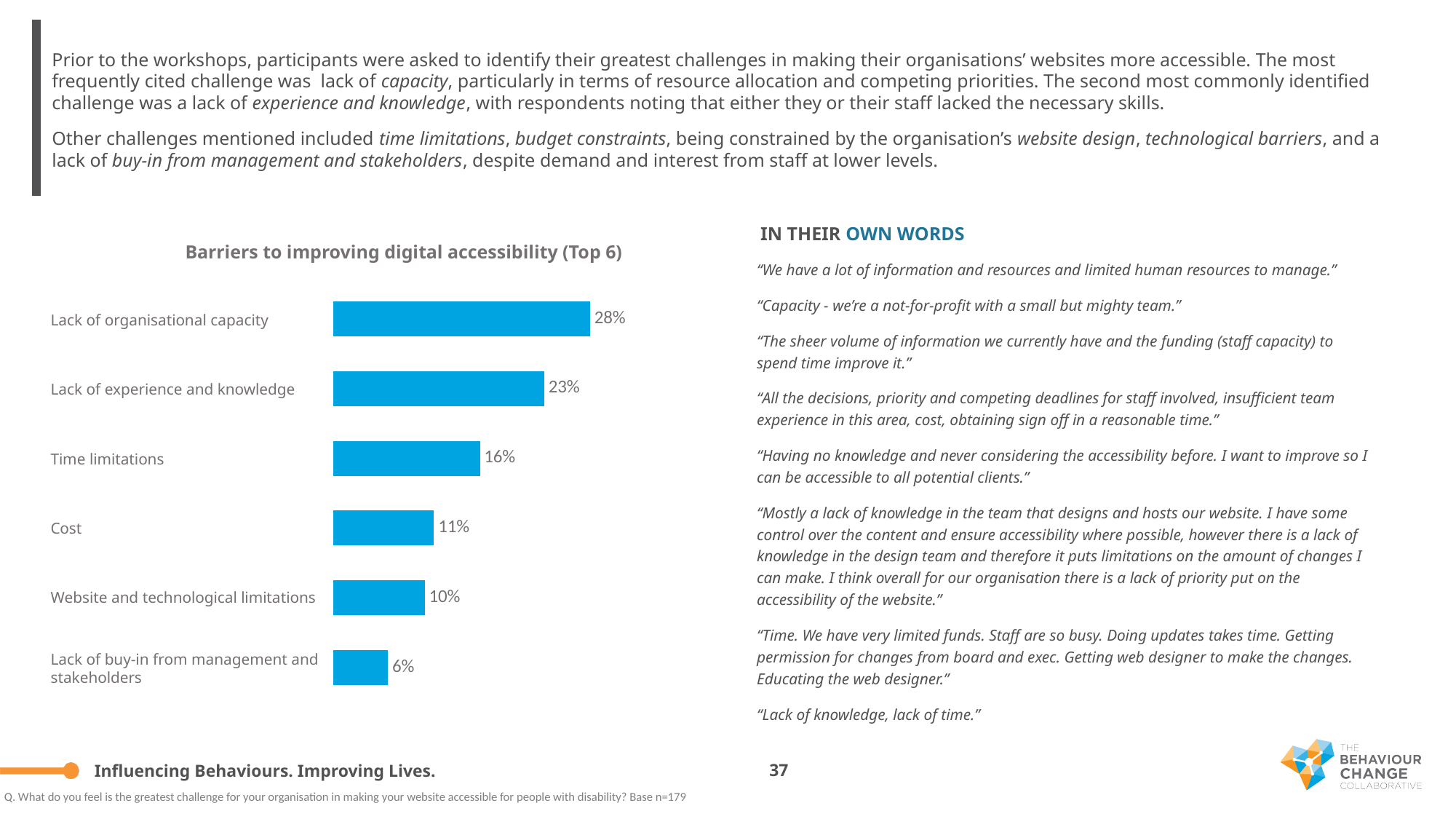
Which barrier has the highest value? Lack of organisational capacity What is the value for Lack of buy-in from management and stakeholders? 6% What is the title of the chart? Barriers to improving digital accessibility (Top 6) How many barriers are shown in the chart? 6 Which is larger, Cost or Website and technological limitations? Cost What is the value for Website and technological limitations? 10% What is the value for Lack of organisational capacity? 28% What is the value for Time limitations? 16% What is the difference between Lack of organisational capacity and Lack of experience and knowledge? 5% What kind of chart is shown on the slide? Bar chart Which barrier has the lowest value? Lack of buy-in from management and stakeholders What is the difference between Time limitations and Cost? 5%